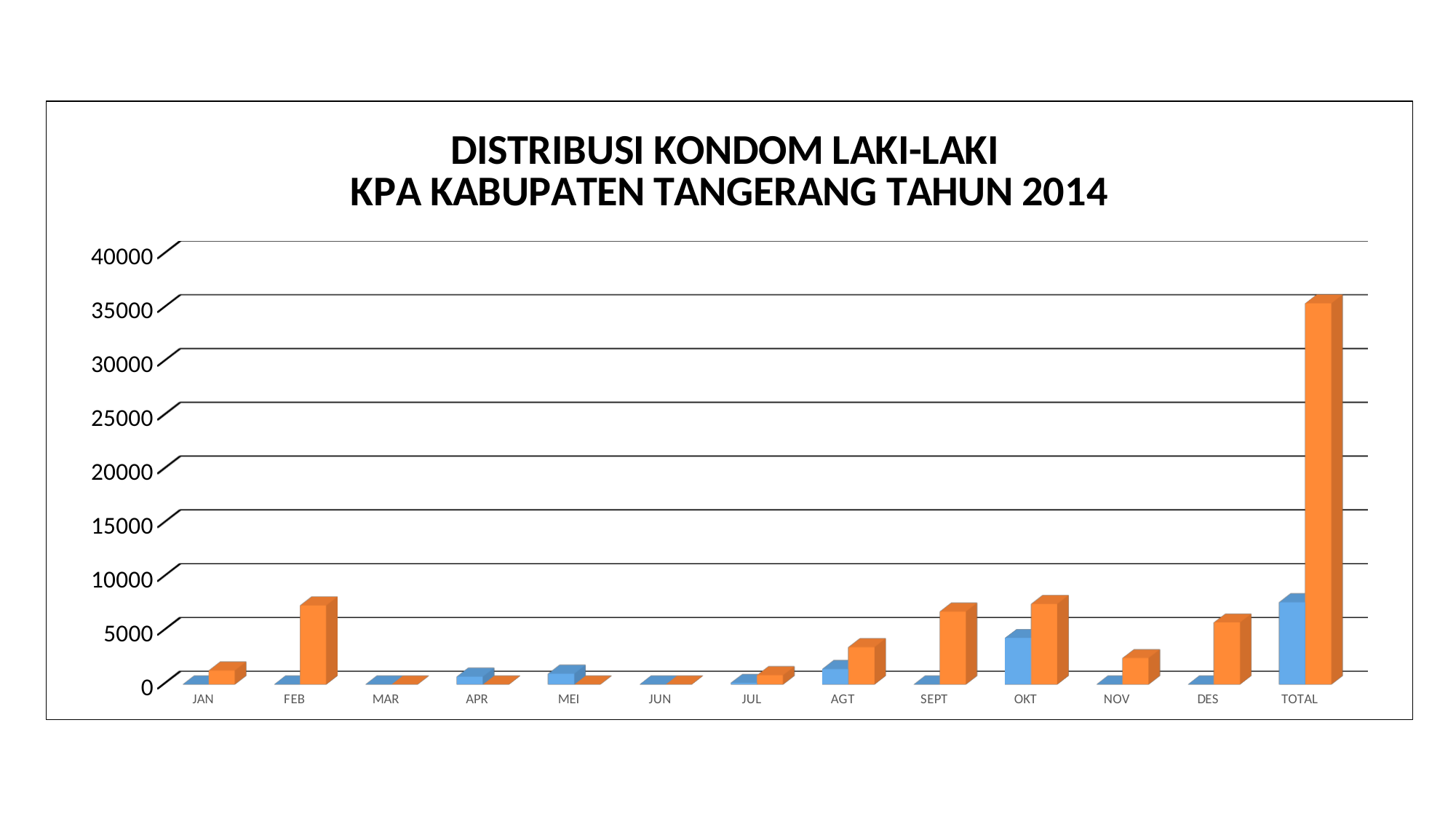
Is the blue bar for OKT greater or less than 5000? less Among the months (excluding TOTAL), which category has the tallest blue bar? OKT Which category has the tallest blue bar? TOTAL Which category has the tallest orange bar? TOTAL Which is larger, the orange bar for FEB or the orange bar for AGT? FEB Is the orange bar for FEB greater or less than 5000? greater Which is larger, the blue bar for OKT or the blue bar for AGT? OKT What is the title of the chart? DISTRIBUSI KONDOM LAKI-LAKI KPA KABUPATEN TANGERANG TAHUN 2014 What kind of chart is shown on the slide? bar chart Is the orange bar for TOTAL greater or less than 30000? greater How many categories are shown on the x axis of the chart? 13